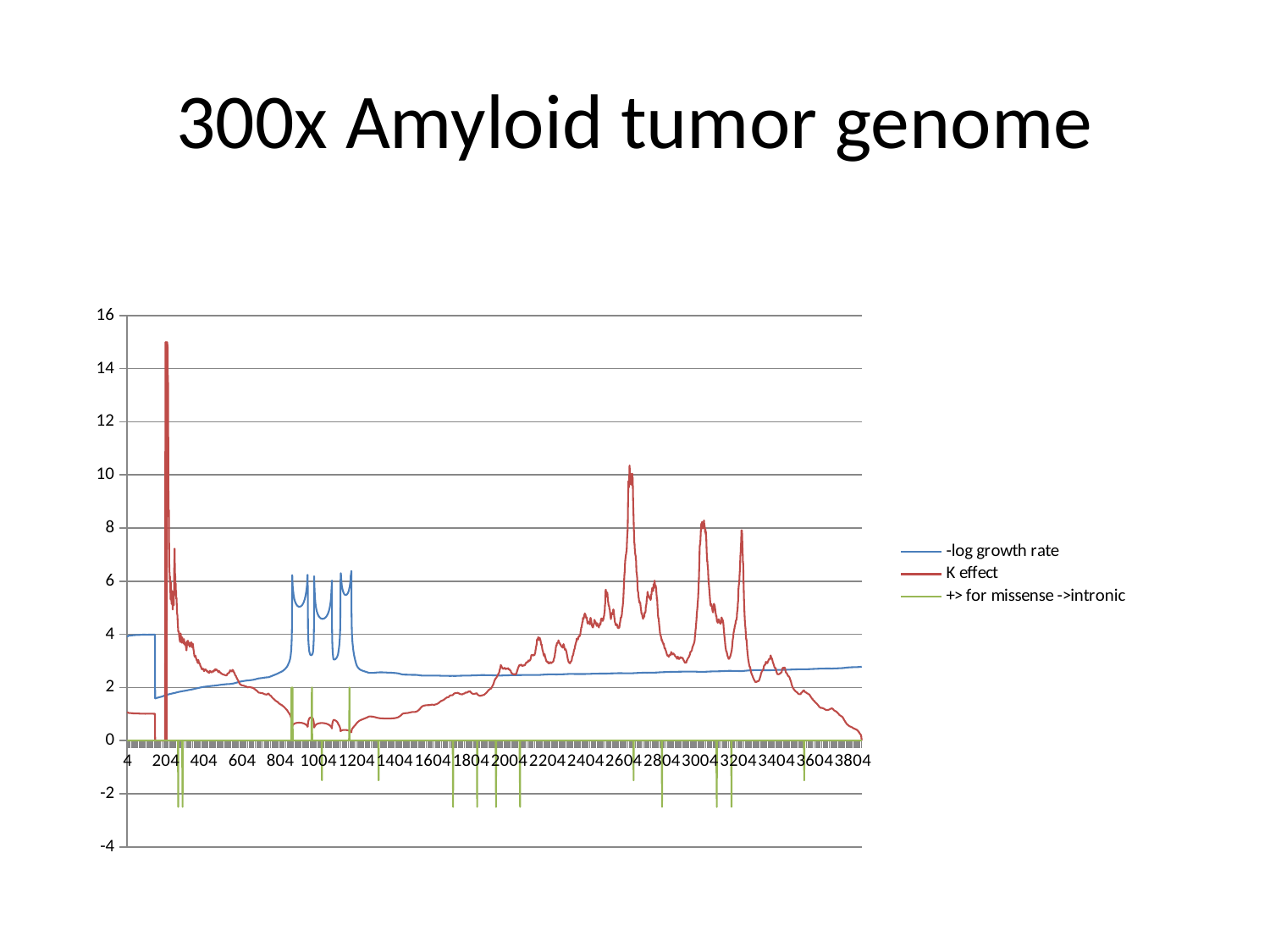
Is the highest peak of the K effect series (near x = 204) greater or less than 14? greater How many series does the legend list? 3 Is the value of -log growth rate at x = 2004 greater or less than 4? less What kind of chart is shown on the slide? line chart What is the title of the slide? 300x Amyloid tumor genome Which series is drawn in red? K effect Is the value of K effect at x = 3804 greater or less than 2? less What is the highest value shown on the y axis? 16 Near x = 2604, which series is higher: K effect or -log growth rate? K effect Which series reaches the highest value on the chart? K effect Near x = 1004, which series is higher: -log growth rate or K effect? -log growth rate